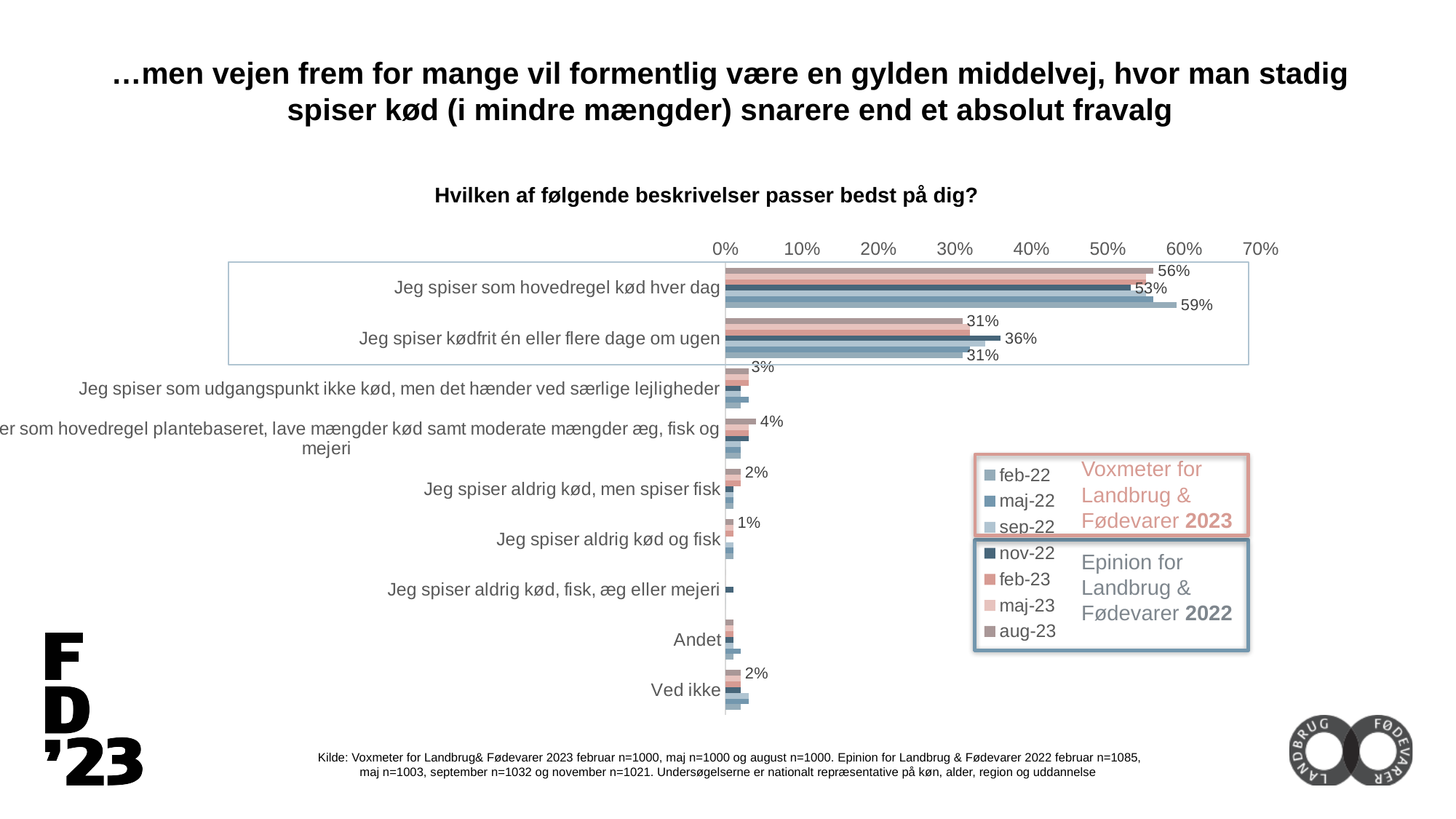
What is the aug-23 value for 'Jeg spiser som hovedregel kød hver dag'? 56% What is the difference between the feb-22 and aug-23 values for 'Jeg spiser som hovedregel kød hver dag'? 3 percentage points How many response categories are plotted on the chart? 9 What kind of chart is shown on the slide? Bar chart What is the nov-22 value for 'Jeg spiser kødfrit én eller flere dage om ugen'? 36% Which response category has the highest values across all series? Jeg spiser som hovedregel kød hver dag What is the aug-23 value for 'Ved ikke'? 2% What is the title of the chart? Hvilken af følgende beskrivelser passer bedst på dig? What is the difference between the nov-22 and aug-23 values for 'Jeg spiser kødfrit én eller flere dage om ugen'? 5 percentage points How many series does the legend list? 7 For 'Jeg spiser kødfrit én eller flere dage om ugen', which is larger: the nov-22 value or the aug-23 value? nov-22 What is the feb-22 value for 'Jeg spiser som hovedregel kød hver dag'? 59%